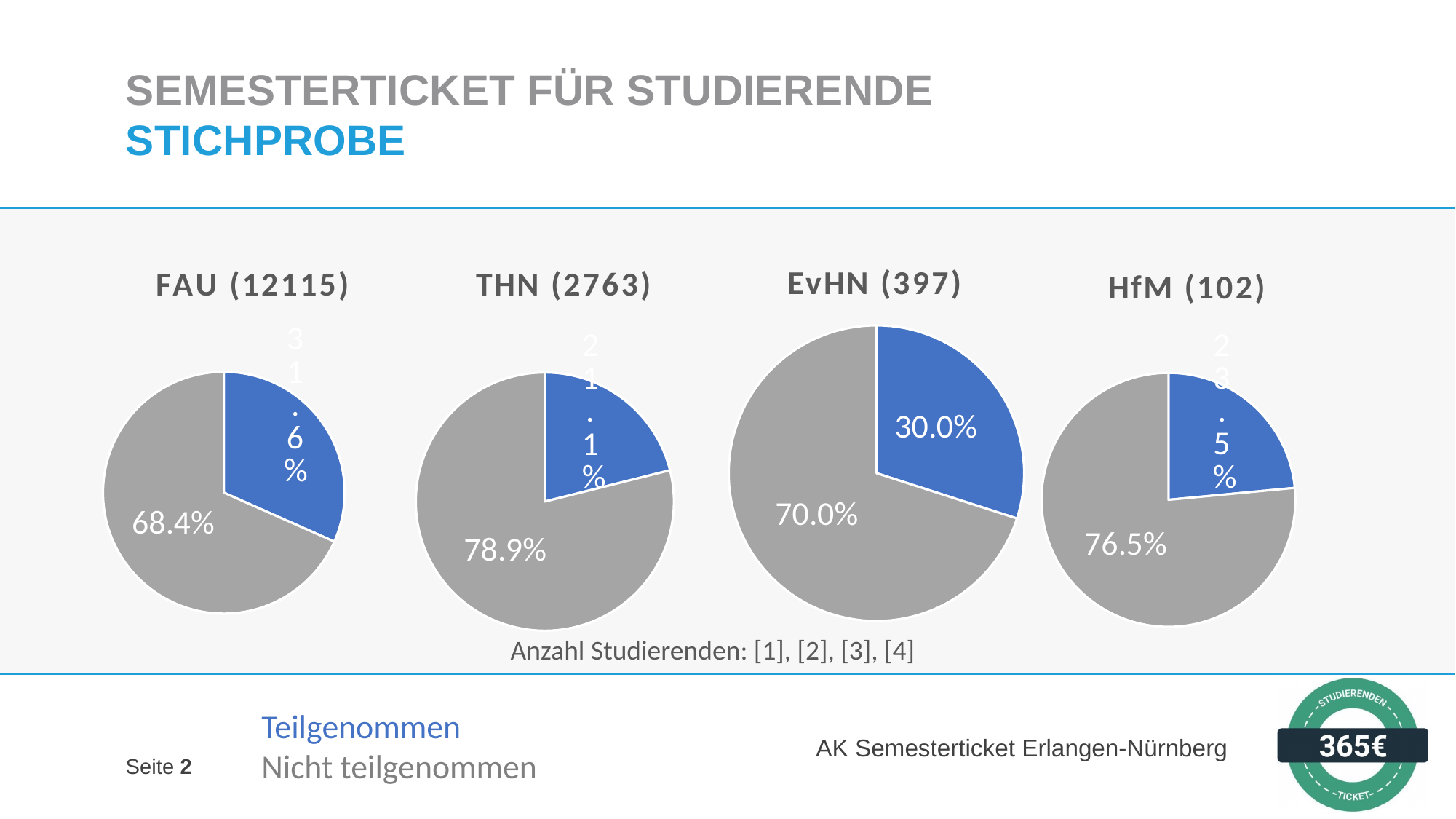
How many slices does each pie chart have? 2 Which pie chart shows the smallest 'Teilgenommen' share? THN (2763) What kind of charts are shown on the slide? Pie charts How many pie charts are shown on the slide? 4 In the FAU (12115) pie chart, what share is labelled for the grey 'Nicht teilgenommen' slice? 68.4% In the EvHN (397) pie chart, what share is shown for 'Teilgenommen'? 30.0% In the EvHN (397) pie chart, what share is shown for 'Nicht teilgenommen'? 70.0% What are the two legend entries shown below the pie charts? Teilgenommen, Nicht teilgenommen In the EvHN (397) pie chart, what is the difference between the 'Nicht teilgenommen' and 'Teilgenommen' shares? 40.0 percentage points Is the 'Teilgenommen' share larger in the EvHN (397) chart or in the HfM (102) chart? EvHN (397) In the THN (2763) pie chart, what share is shown for 'Nicht teilgenommen'? 78.9% In the HfM (102) pie chart, what share is shown for 'Nicht teilgenommen'? 76.5%